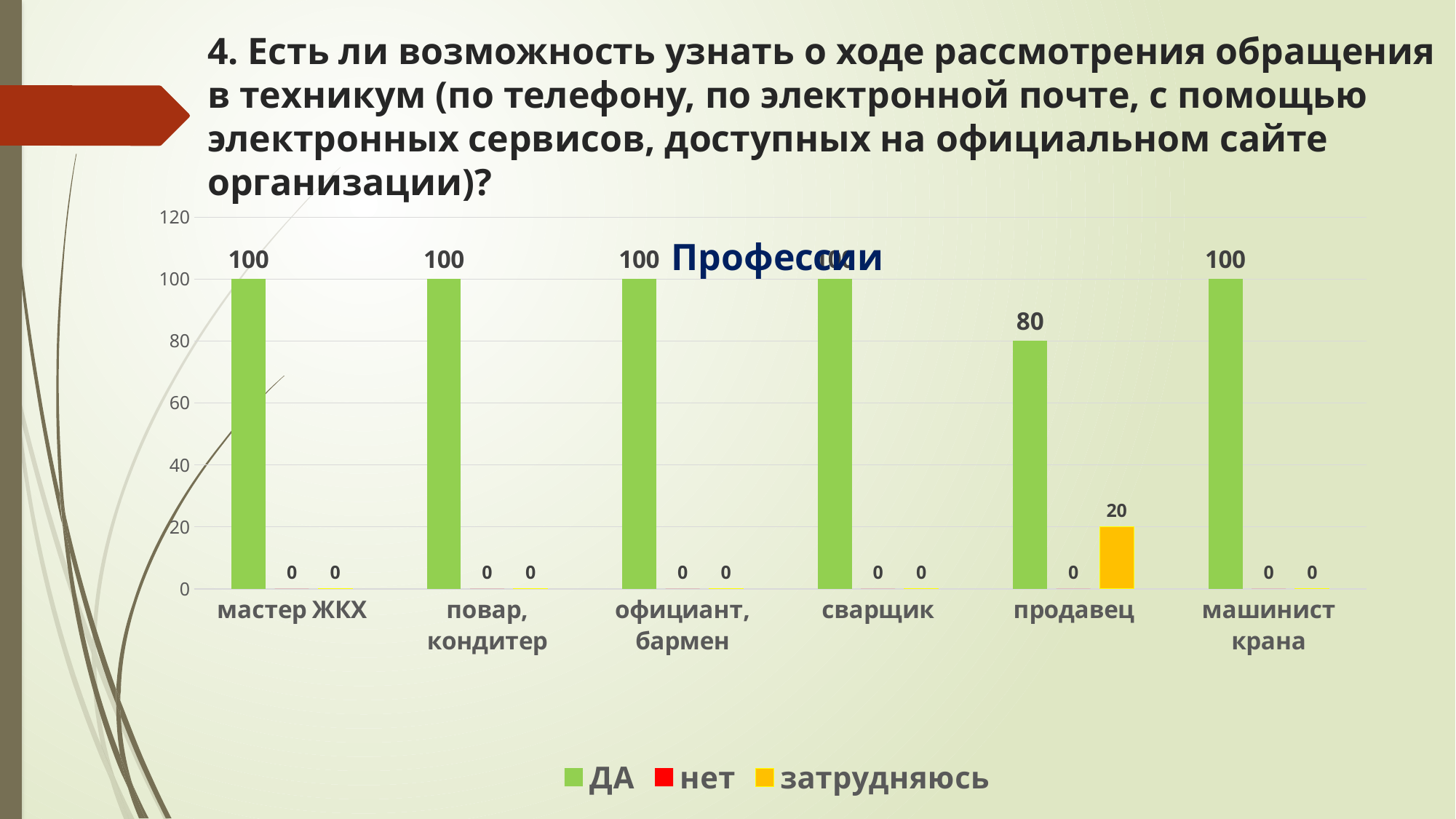
What is the title of the chart? Профессии What is the value of the нет series for мастер ЖКХ? 0 What is the value of the затрудняюсь series for продавец? 20 Which category has the highest value in the затрудняюсь series? продавец How many categories are shown on the x axis? 6 What is the value of the ДА series for сварщик? 100 Which is larger for продавец: the ДА value or the затрудняюсь value? ДА What is the difference between the ДА value for машинист крана and the ДА value for продавец? 20 Which category has the lowest value in the ДА series? продавец What is the value of the ДА series for продавец? 80 What kind of chart is shown on the slide? bar chart How many series does the legend list? 3